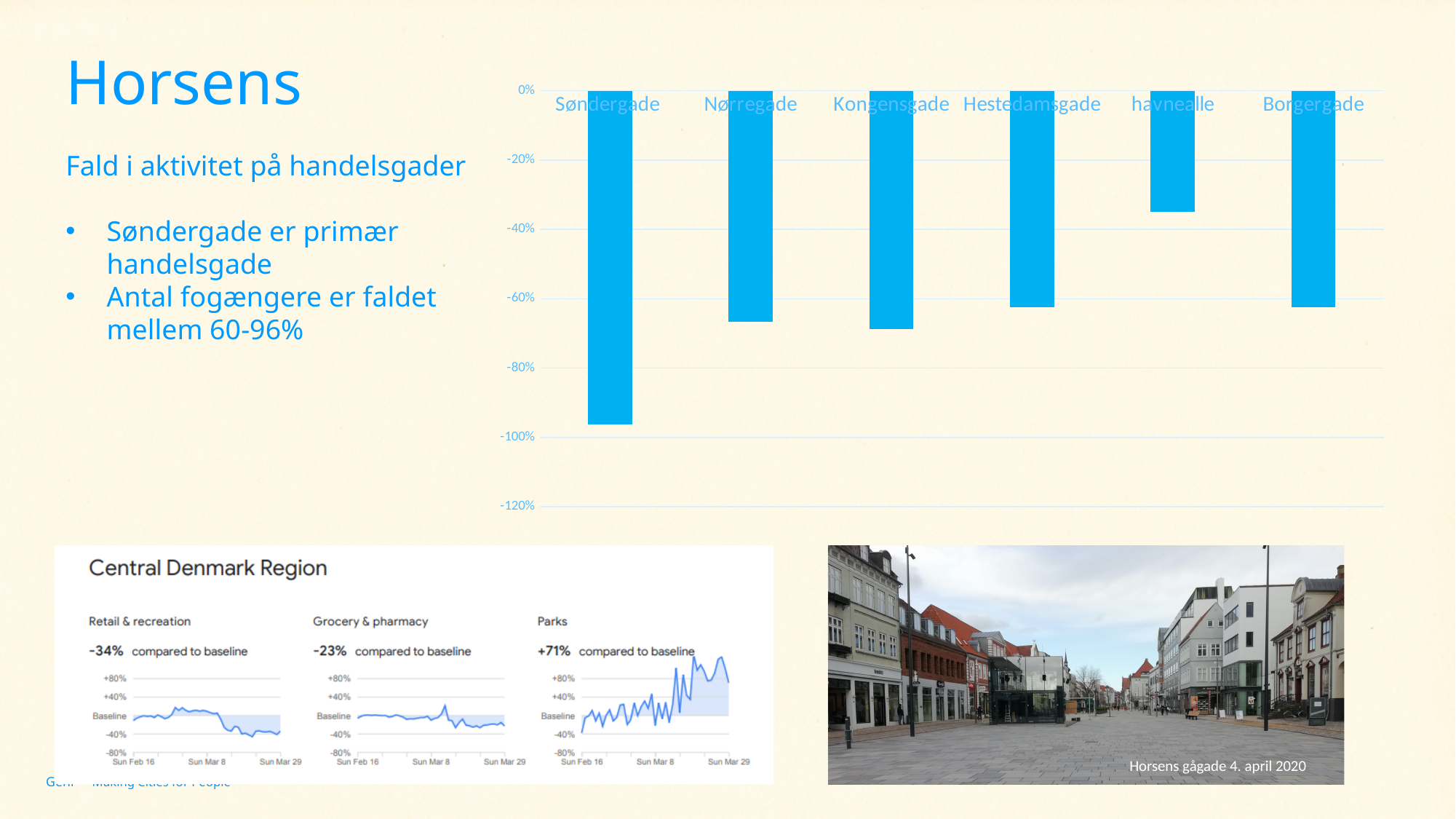
In the Central Denmark Region panel at the bottom left, what is the Retail & recreation change compared to baseline? -34% In the bar chart at the top right, which street shows the smallest fall in activity? havnealle In the bar chart at the top right, which street shows the largest fall in activity? Søndergade How many streets are shown in the bar chart at the top right? 6 In the bar chart at the top right, is the value for Søndergade greater or less than -80%? less In the bar chart at the top right, is the value for Nørregade greater or less than -60%? less In the bar chart at the top right, is the value for havnealle greater or less than -40%? greater What kind of chart is the large chart at the top right of the slide? bar chart In the bar chart at the top right, which bar is longer: Søndergade or havnealle? Søndergade In the Central Denmark Region panel at the bottom left, what is the Parks change compared to baseline? +71% In the Central Denmark Region panel at the bottom left, what is the Grocery & pharmacy change compared to baseline? -23%